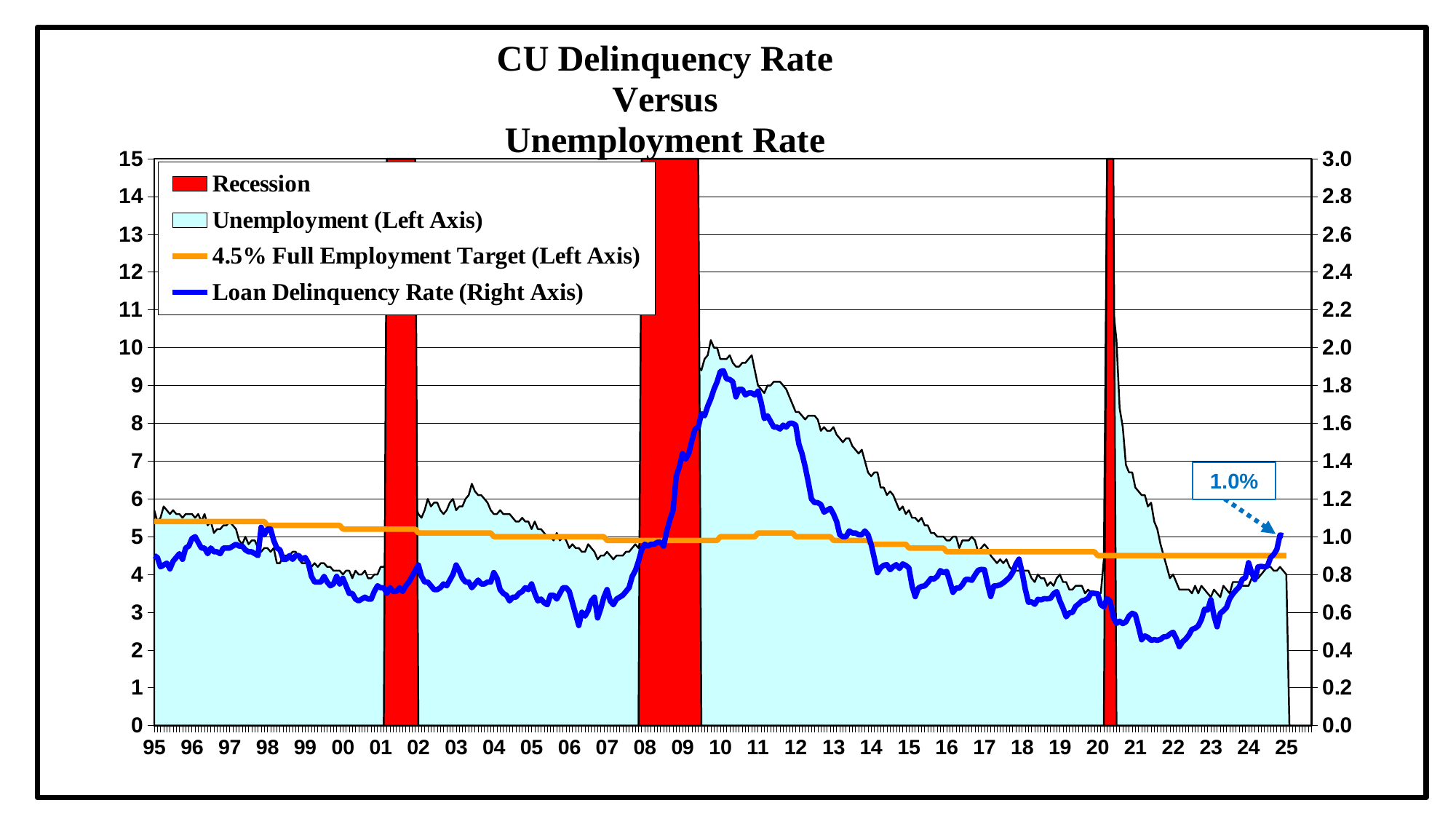
Does the Unemployment series rise or fall between 2010 and 2019? fall Does the Loan Delinquency Rate rise or fall between 2021 and 2025? rise What value is labelled for the Loan Delinquency Rate at the end of the series in 2025? 1.0% In which year does the Unemployment series reach its highest peak? 2020 How many recession periods are shaded on the chart? 3 How many entries does the chart legend list? 4 Is the Unemployment value in 2019 greater or less than 5? less What is the title of the chart? CU Delinquency Rate Versus Unemployment Rate Is the Loan Delinquency Rate in 2021 greater or less than 0.6? less Is the Loan Delinquency Rate higher in 2010 or in 2022? 2010 Is the Unemployment value in 2010 greater or less than 8? greater What kind of chart is used to plot the Loan Delinquency Rate series? Line chart